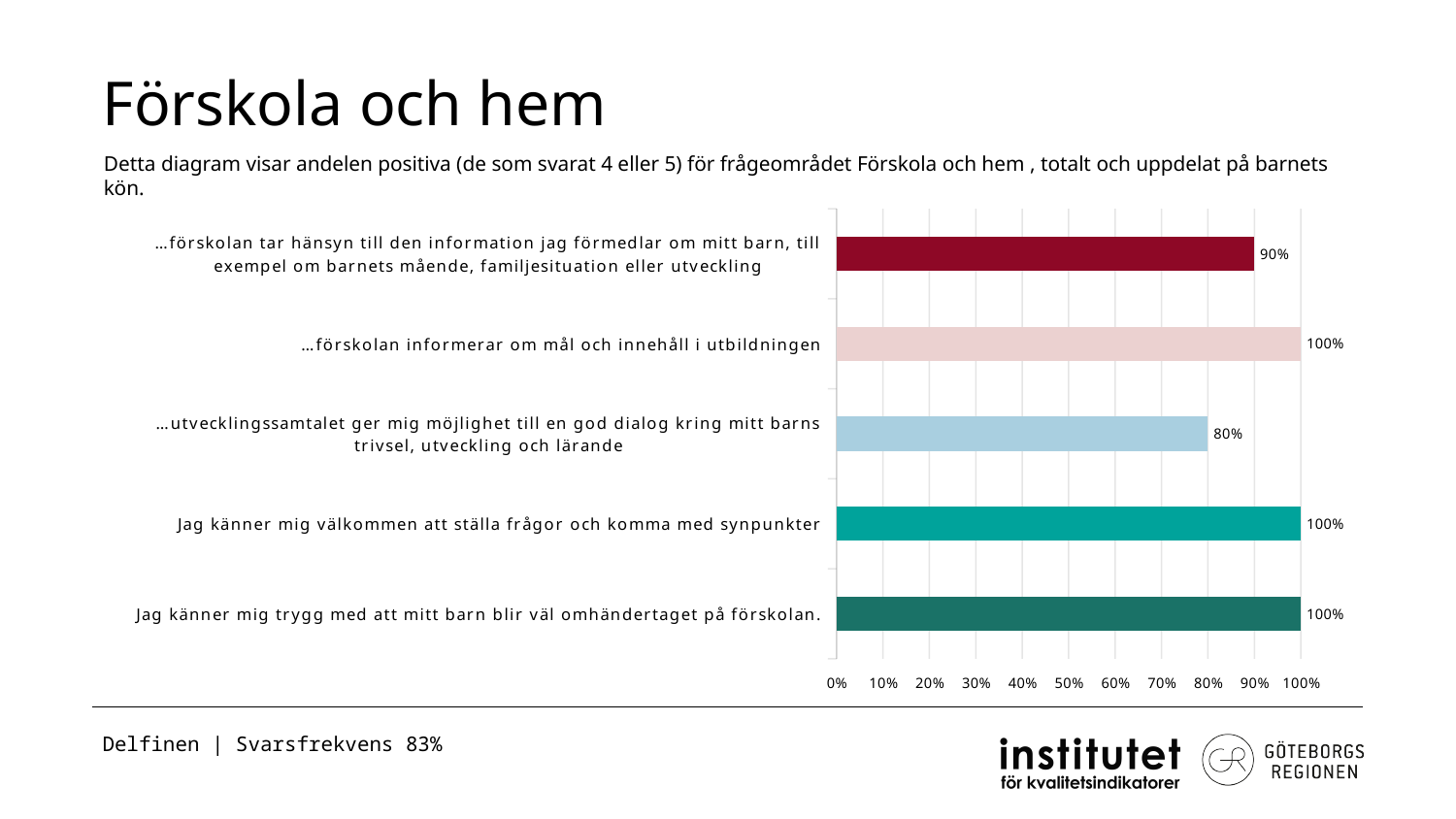
What is the value for "…utvecklingssamtalet ger mig möjlighet till en god dialog kring mitt barns trivsel, utveckling och lärande"? 80% What is the difference between the value for "…förskolan tar hänsyn till den information jag förmedlar om mitt barn…" and the value for "…utvecklingssamtalet ger mig möjlighet till en god dialog…"? 10% How many categories (statements) are plotted in the chart? 5 What is the highest value shown on the x axis of the chart? 100% What is the title of the slide containing the chart? Förskola och hem Which statement has the lowest value in the chart? …utvecklingssamtalet ger mig möjlighet till en god dialog kring mitt barns trivsel, utveckling och lärande Which is larger: the value for "Jag känner mig trygg med att mitt barn blir väl omhändertaget på förskolan." or the value for "…förskolan tar hänsyn till den information jag förmedlar om mitt barn…"? Jag känner mig trygg med att mitt barn blir väl omhändertaget på förskolan. What is the value for "…förskolan informerar om mål och innehåll i utbildningen"? 100% What is the value for "Jag känner mig välkommen att ställa frågor och komma med synpunkter"? 100% How many statements in the chart have a value of 100%? 3 What is the value for "…förskolan tar hänsyn till den information jag förmedlar om mitt barn, till exempel om barnets mående, familjesituation eller utveckling"? 90% What kind of chart is shown on the slide? bar chart